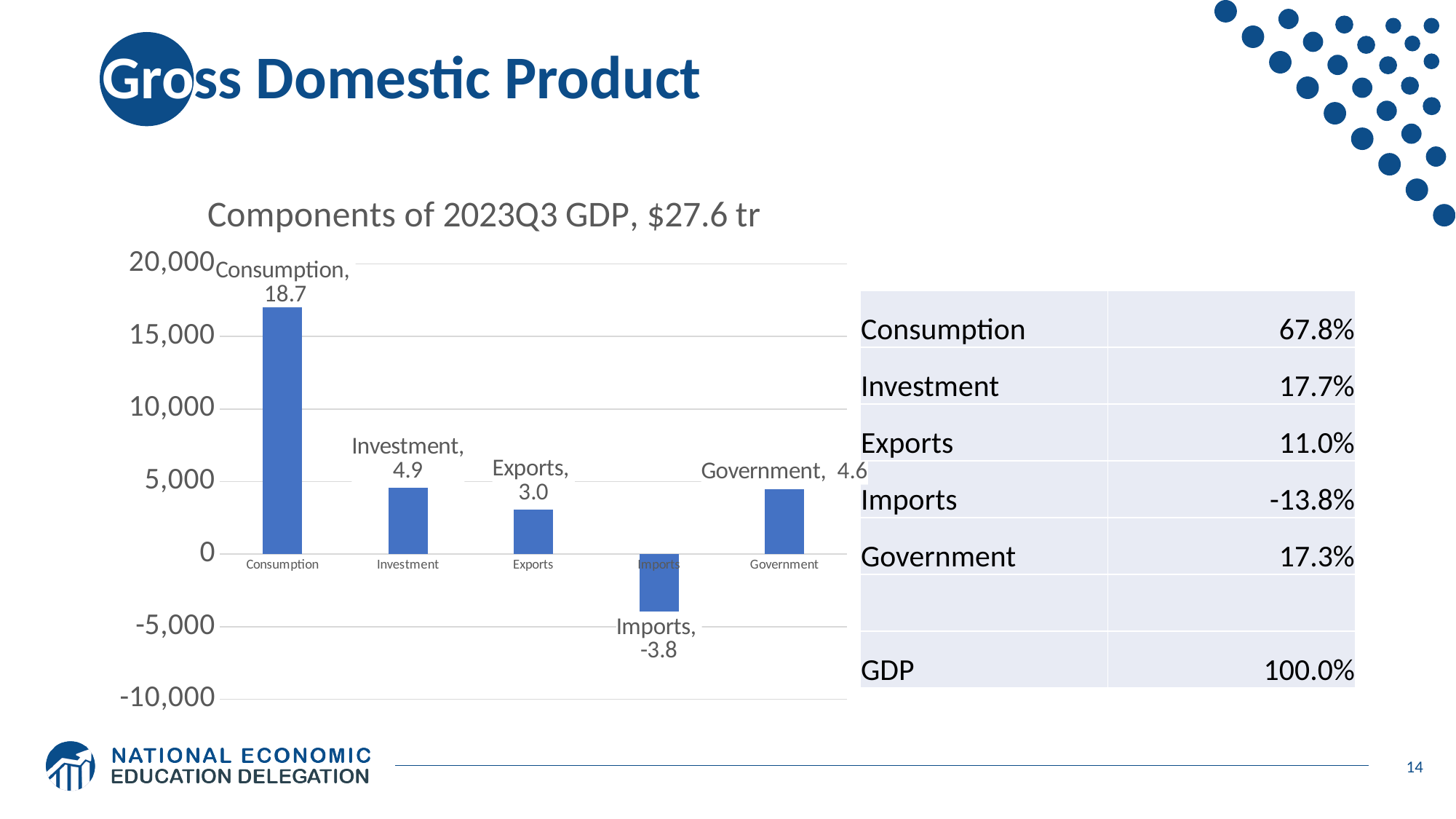
What is the value labelled for Government in the chart? 4.6 What is the title of the chart? Components of 2023Q3 GDP, $27.6 tr What is the difference between the labelled values for Consumption and Investment? 13.8 Which category has the lowest value in the chart? Imports What is the value labelled for Investment in the chart? 4.9 Which is larger, the value for Exports or the value for Investment? Investment Is the bar for Consumption greater or less than 15,000 on the axis? greater Which category has the highest value in the chart? Consumption What is the value labelled for Consumption in the chart? 18.7 What is the value labelled for Imports in the chart? -3.8 What kind of chart is shown on the slide? bar chart How many categories are plotted in the chart? 5